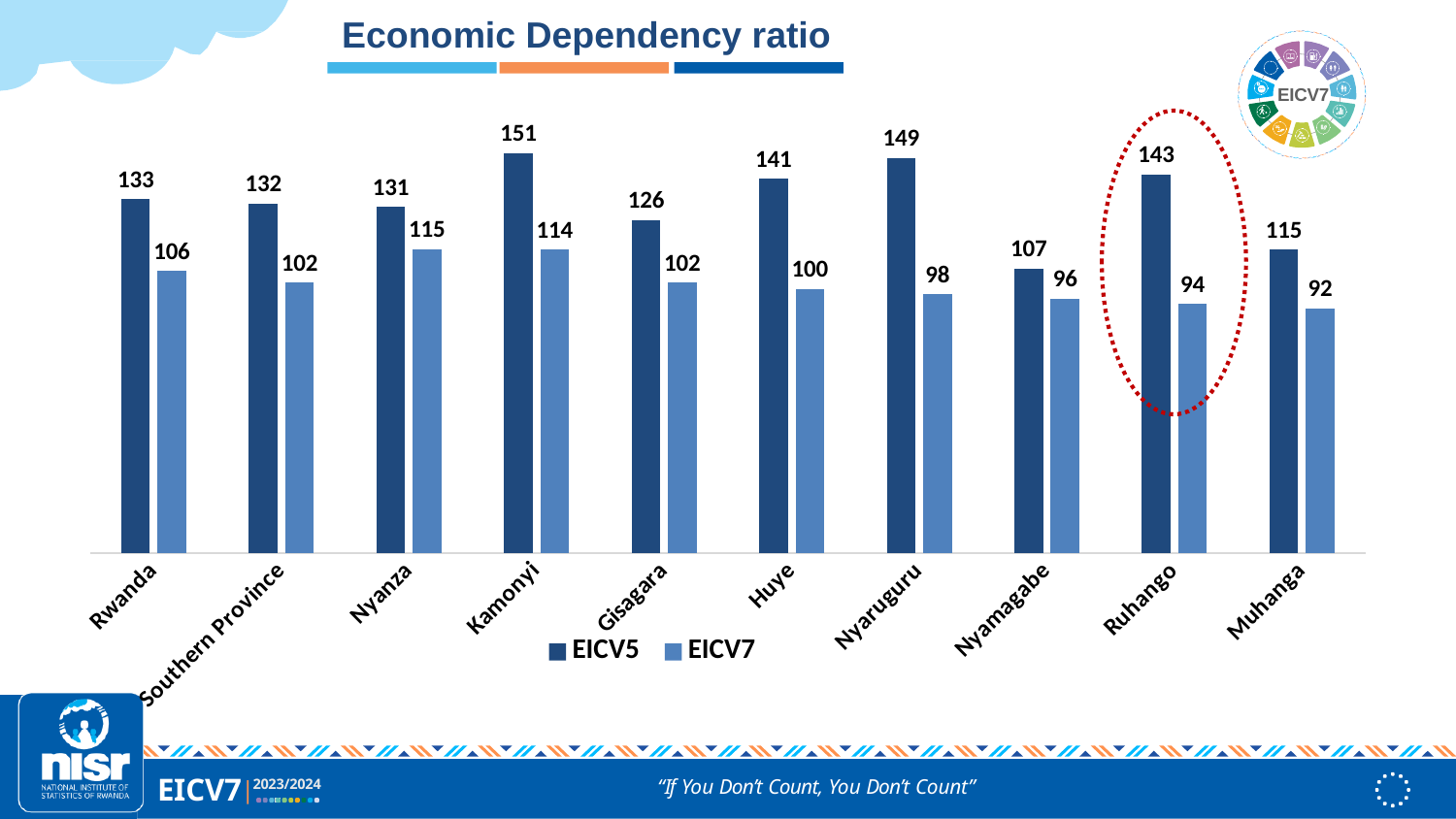
Which district or region has the lowest EICV5 value? Nyamagabe What is the EICV7 value for Rwanda? 106 How many categories are shown on the x axis? 10 What is the EICV5 value for Kamonyi? 151 What kind of chart is shown on the slide? Bar chart What is the difference between the EICV5 and EICV7 values for Nyaruguru? 51 Which district or region has the highest EICV5 value? Kamonyi What is the EICV7 value for Ruhango? 94 Which is larger, the EICV7 value for Nyanza or the EICV7 value for Huye? Nyanza Which district or region has the lowest EICV7 value? Muhanga What is the title of the chart? Economic Dependency ratio How many series does the legend list? 2